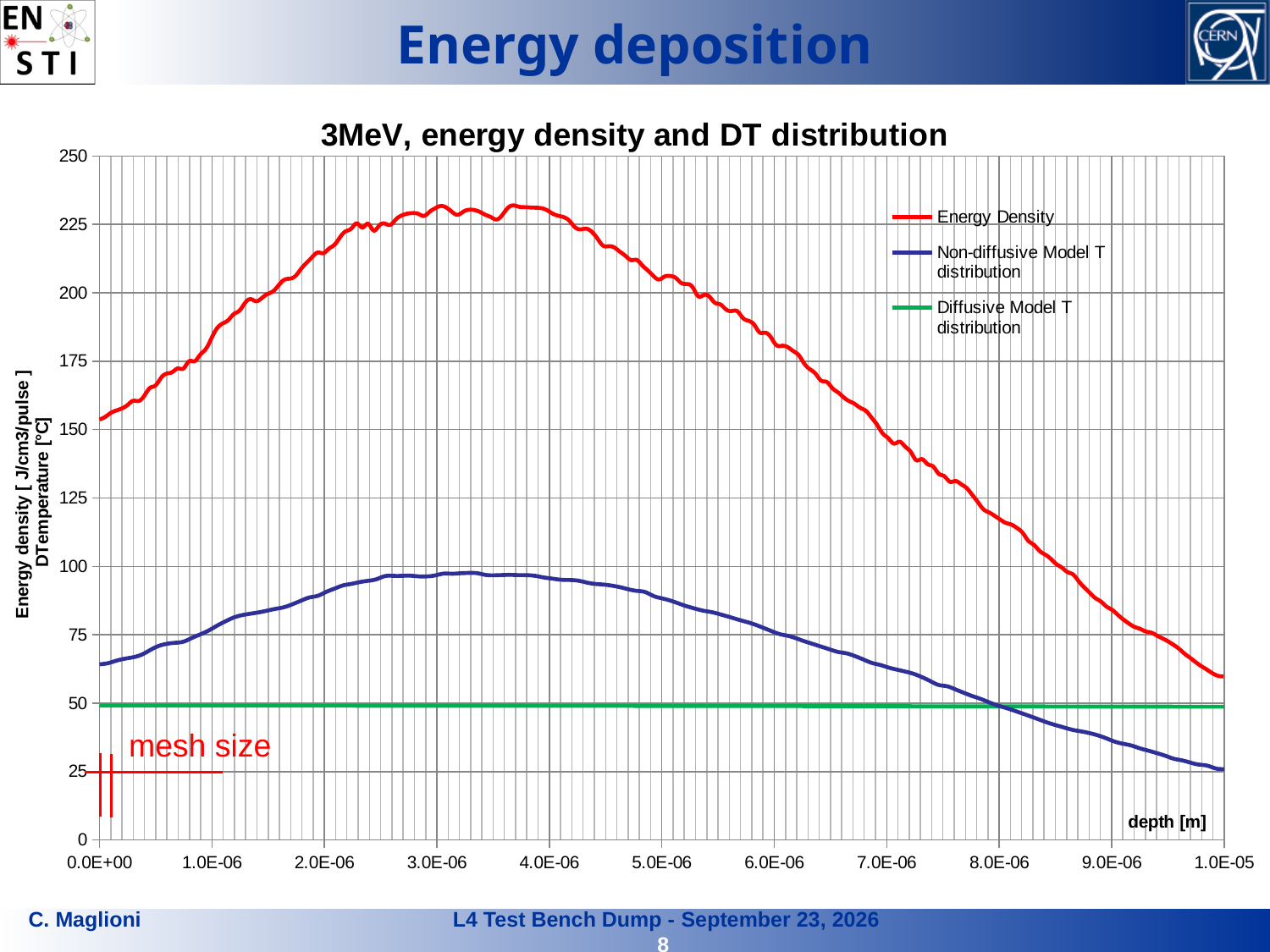
Is the peak value of the Energy Density curve greater or less than 225? greater At depth 5.0E-06, which is larger: Energy Density or Non-diffusive Model T distribution? Energy Density How many series does the legend list? 3 Does the Energy Density curve rise or fall between depth 4.0E-06 and 1.0E-05? fall Is the Energy Density value at depth 0.0E+00 greater or less than 150? greater What is the title of the chart? 3MeV, energy density and DT distribution Is the peak value of the Non-diffusive Model T distribution curve greater or less than 100? less Does the Non-diffusive Model T distribution curve rise or fall between depth 0.0E+00 and 3.0E-06? rise What kind of chart is shown on the slide? line chart What is the label of the x axis? depth [m]